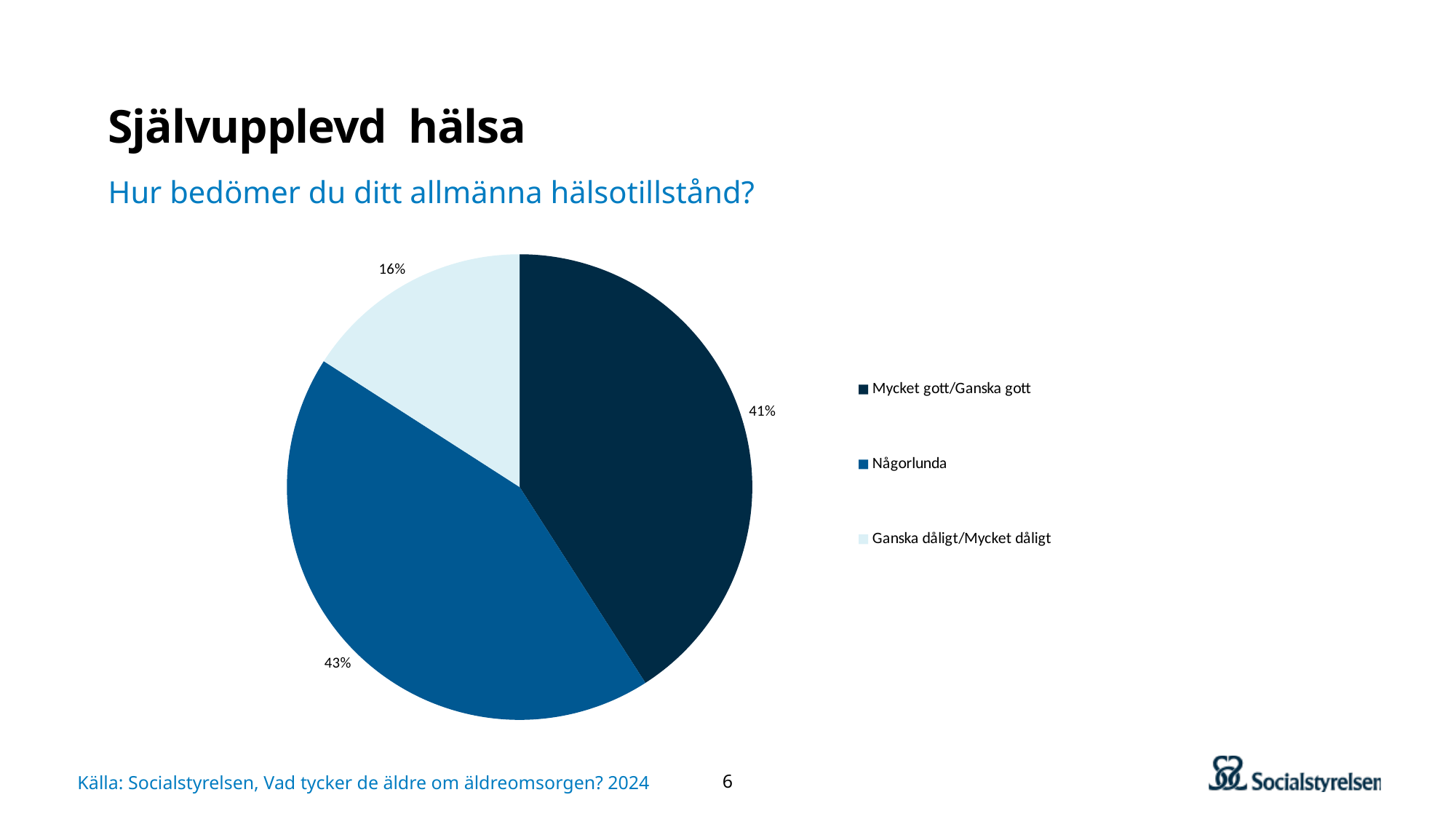
What question is the pie chart answering, according to the subtitle? Hur bedömer du ditt allmänna hälsotillstånd? What is the difference in percentage points between "Mycket gott/Ganska gott" and "Ganska dåligt/Mycket dåligt"? 25 percentage points What percentage of respondents answered "Ganska dåligt/Mycket dåligt"? 16% Which is larger, the share for "Mycket gott/Ganska gott" or the share for "Ganska dåligt/Mycket dåligt"? Mycket gott/Ganska gott How many entries does the legend list? 3 Which category has the largest share of the pie? Någorlunda What percentage of respondents answered "Mycket gott/Ganska gott"? 41% What is the difference in percentage points between "Någorlunda" and "Mycket gott/Ganska gott"? 2 percentage points What percentage of respondents answered "Någorlunda"? 43% What kind of chart is shown on the slide? pie chart Which category has the smallest share of the pie? Ganska dåligt/Mycket dåligt How many slices does the pie chart have? 3